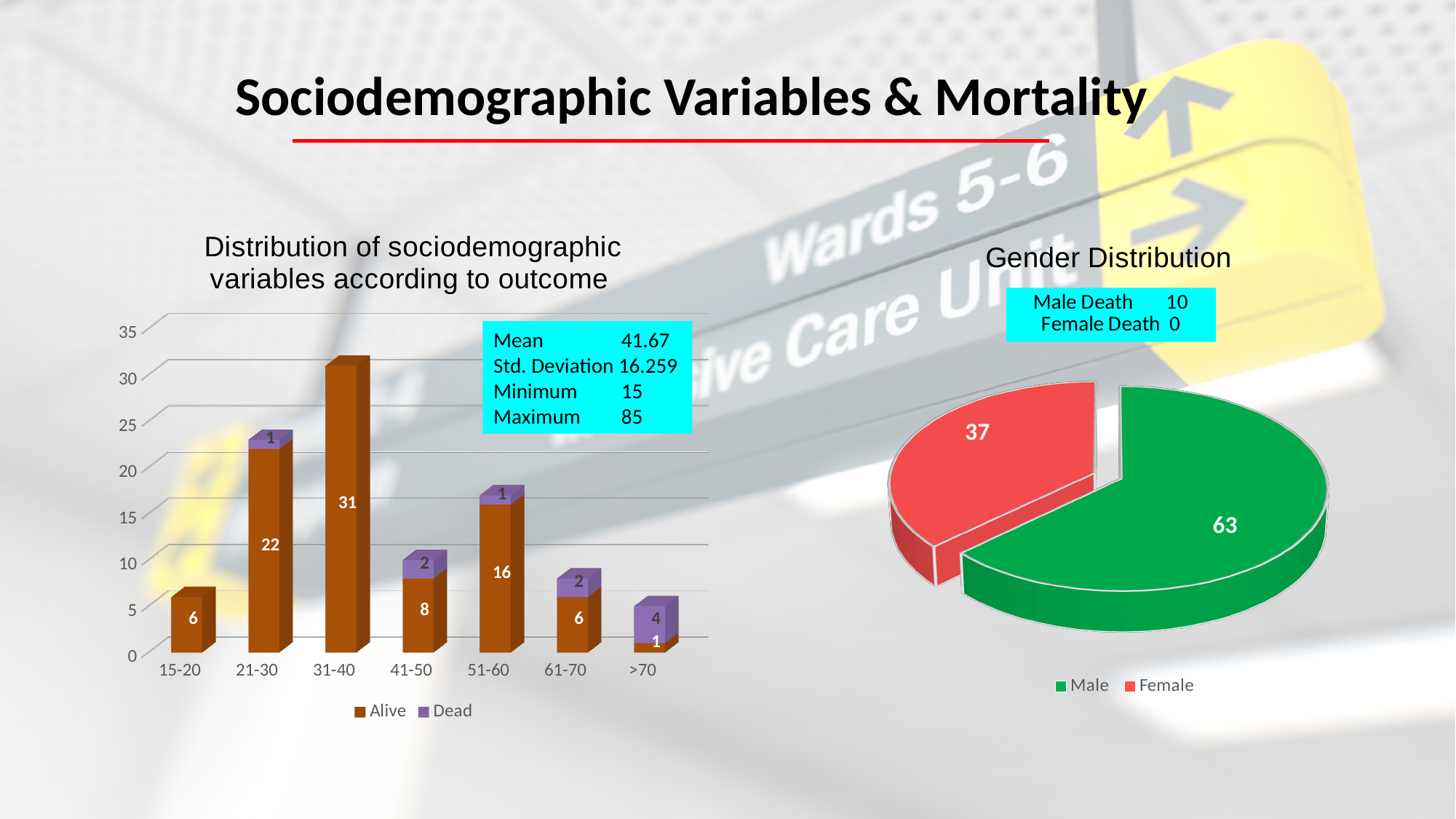
In the 'Distribution of sociodemographic variables according to outcome' chart, which age group has the highest Dead value? >70 In the 'Distribution of sociodemographic variables according to outcome' chart, which age group has the highest Alive value? 31-40 In the 'Gender Distribution' pie chart, what is the value for Female? 37 In the 'Gender Distribution' pie chart, what share of the total does the Male slice represent? 63% In the 'Distribution of sociodemographic variables according to outcome' chart, what is the total of the stacked bar for the 41-50 age group? 10 What kind of chart is the 'Distribution of sociodemographic variables according to outcome' chart? Stacked bar chart In the 'Distribution of sociodemographic variables according to outcome' chart, what is the Alive value for the 31-40 age group? 31 In the 'Gender Distribution' pie chart, which slice is larger, Male or Female? Male In the 'Distribution of sociodemographic variables according to outcome' chart, what is the Dead value for the >70 age group? 4 In the 'Distribution of sociodemographic variables according to outcome' chart, what is the difference between the Alive values for 21-30 and 51-60? 6 In the 'Distribution of sociodemographic variables according to outcome' chart, how many series does the legend list? 2 In the 'Distribution of sociodemographic variables according to outcome' chart, how many age groups are shown on the x axis? 7